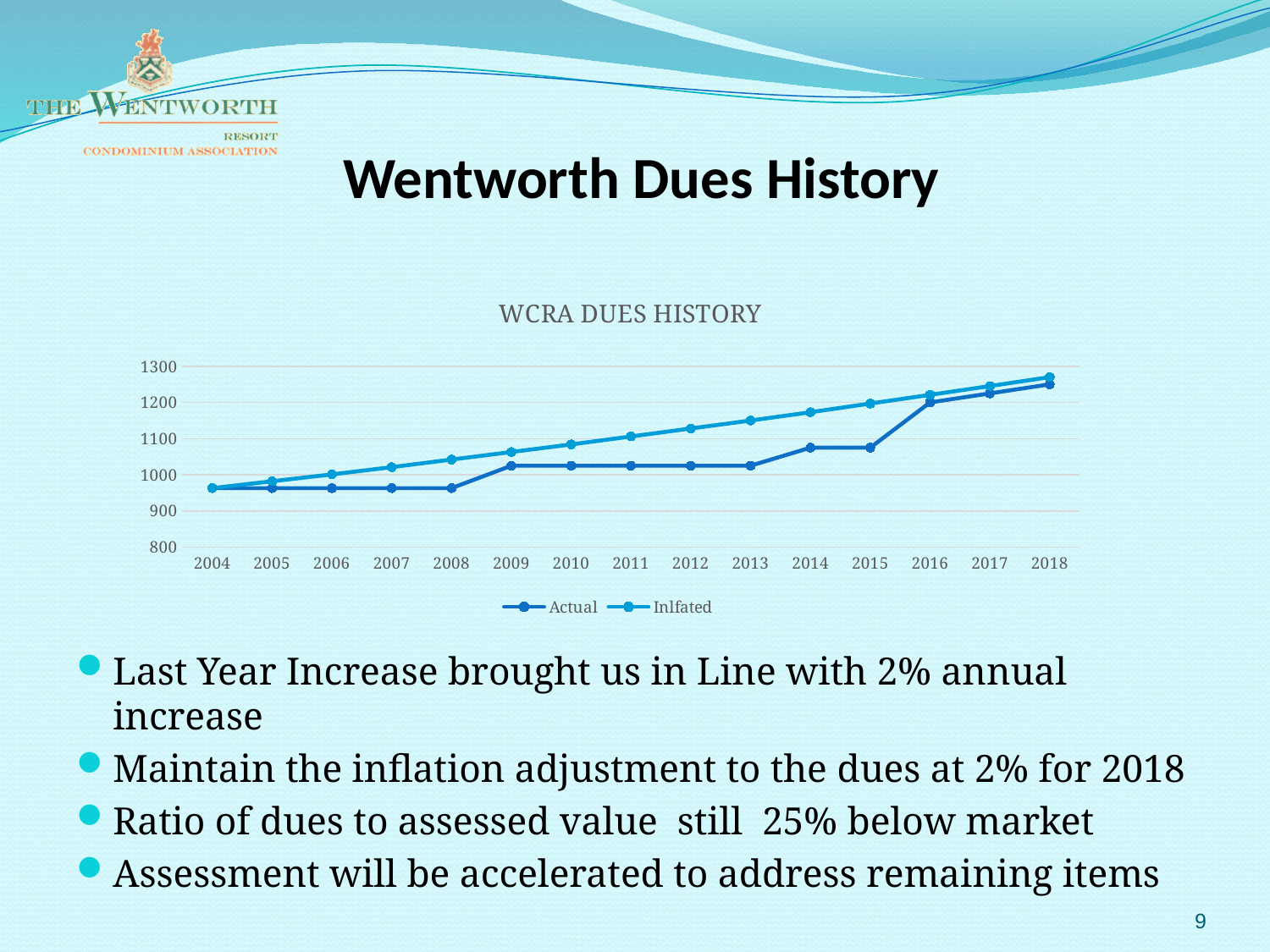
What kind of chart is shown on the slide? line chart In which year does the Inflated series reach its highest value? 2018 Which two series are listed in the chart's legend? Actual and Inlfated What is the title of the chart? WCRA DUES HISTORY How many series does the legend of the WCRA DUES HISTORY chart list? 2 In 2013, which series has the larger value, Actual or Inflated? Inflated Is the Actual value for 2014 greater or less than 1100? less Is the Actual value for 2004 greater or less than 1000? less How many years are plotted along the x axis of the chart? 15 Is the Inflated value for 2013 greater or less than 1100? greater Does the Inflated series rise or fall from 2004 to 2018? rise